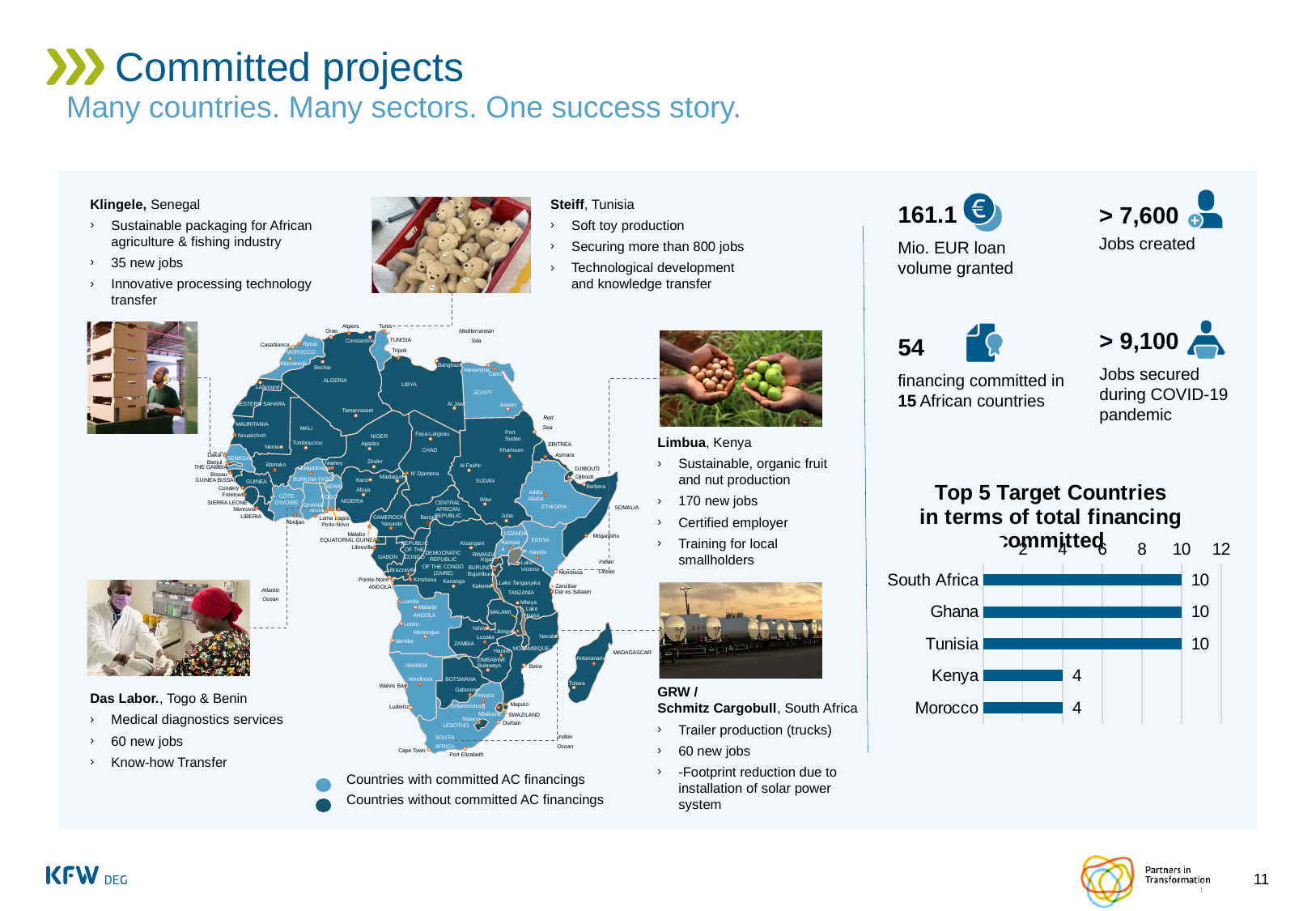
What is the value for South Africa in the Top 5 Target Countries chart? 10 In the Top 5 Target Countries chart, is the value for Kenya greater or less than 6? less How many countries are shown in the Top 5 Target Countries chart? 5 In the Top 5 Target Countries chart, which is larger, the value for Tunisia or the value for Kenya? Tunisia What kind of chart is the Top 5 Target Countries chart? bar chart What is the value for Ghana in the Top 5 Target Countries chart? 10 What is the value for Kenya in the Top 5 Target Countries chart? 4 What is the title of the chart on the right side of the slide? Top 5 Target Countries in terms of total financing committed In the Top 5 Target Countries chart, is the value for Ghana greater or less than 8? greater What is the value for Morocco in the Top 5 Target Countries chart? 4 In the Top 5 Target Countries chart, what is the difference between the values for South Africa and Morocco? 6 What is the value for Tunisia in the Top 5 Target Countries chart? 10